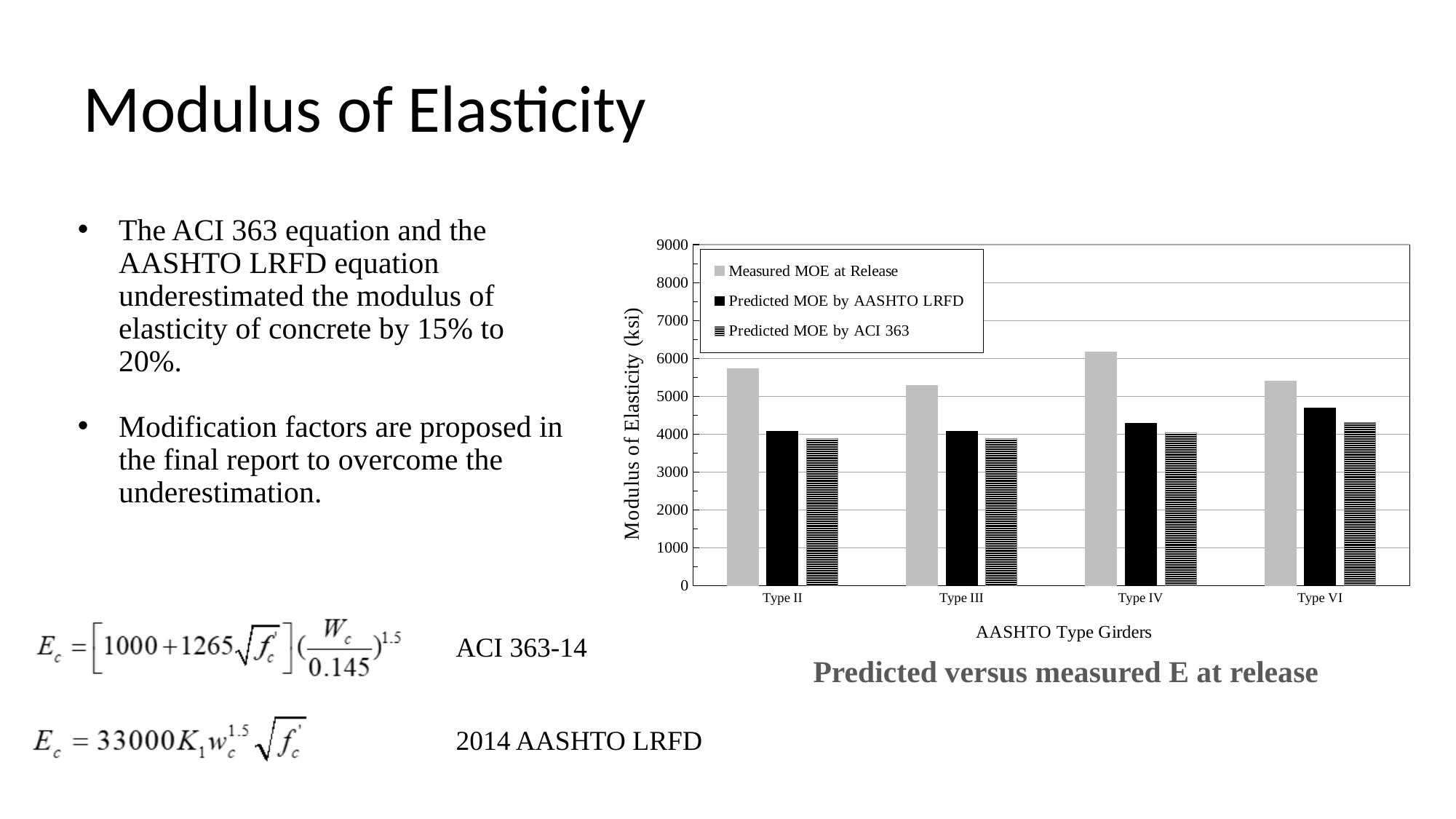
Which girder type has the highest Measured MOE at Release? Type IV What is the label of the chart's y axis? Modulus of Elasticity (ksi) What is the title of the chart? Predicted versus measured E at release Is the Measured MOE at Release for Type IV greater or less than 6000? greater Is the Predicted MOE by ACI 363 for Type II greater or less than 4000? less Which girder type has the highest Predicted MOE by ACI 363? Type VI For Type IV, which is larger: the Measured MOE at Release or the Predicted MOE by AASHTO LRFD? Measured MOE at Release Is the Predicted MOE by AASHTO LRFD for Type VI greater or less than 4000? greater How many series does the chart legend list? 3 Which girder type has the highest Predicted MOE by AASHTO LRFD? Type VI How many girder types are shown on the x axis of the chart? 4 What kind of chart is shown on the slide? bar chart